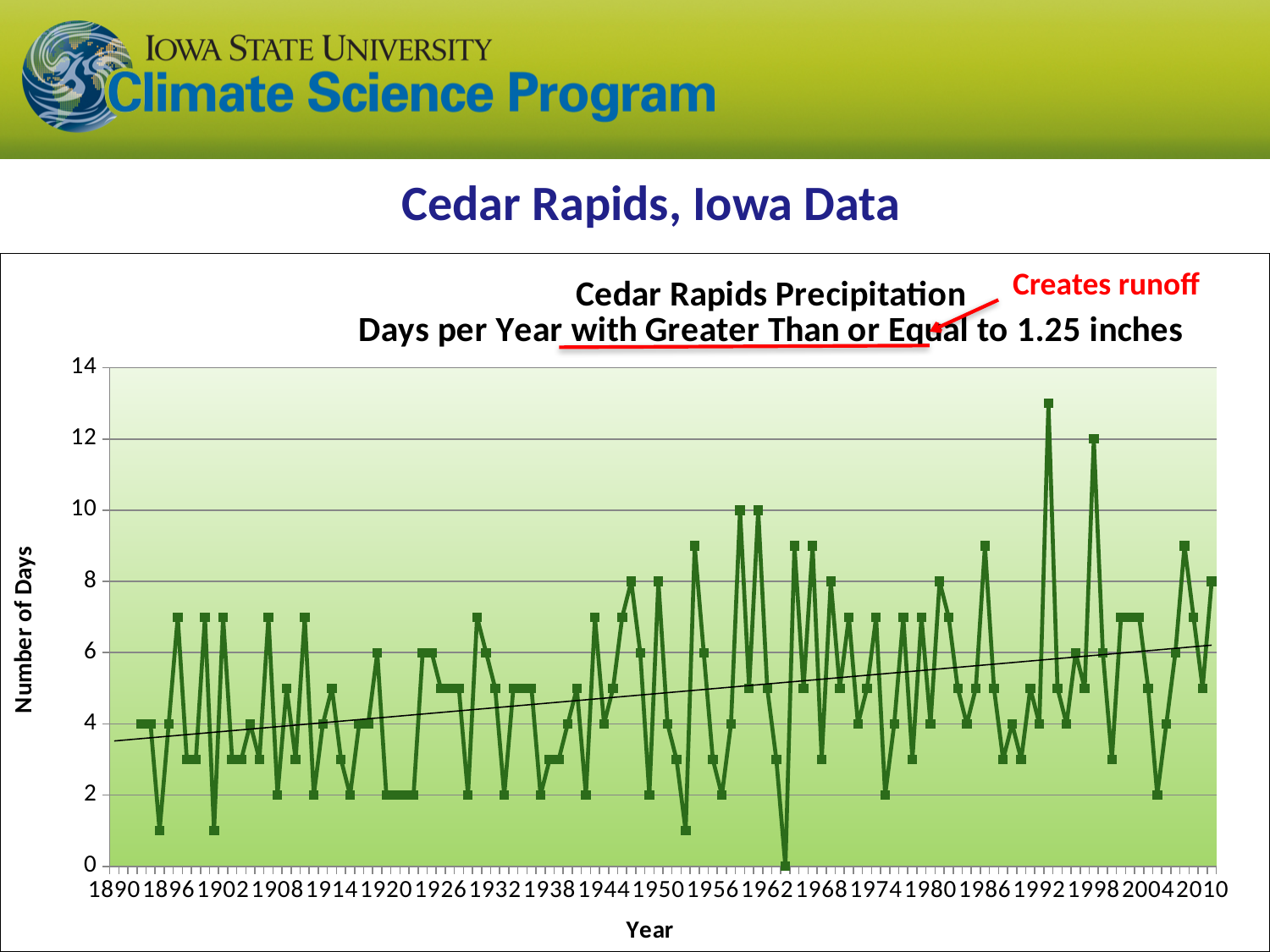
Is the peak value near 1998 greater or less than 10? greater Does the trend line for the number of days rise or fall from 1890 to 2010? rises Is the value for 2010 greater or less than 6? less What kind of chart is shown on the slide? line chart What is the maximum value shown on the y-axis? 14 Is the trend line value at 2010 greater or less than 4? greater What is the lowest value plotted on the chart? 0 What does the red annotation next to the chart title say? Creates runoff What is the title of the chart? Cedar Rapids Precipitation Days per Year with Greater Than or Equal to 1.25 inches